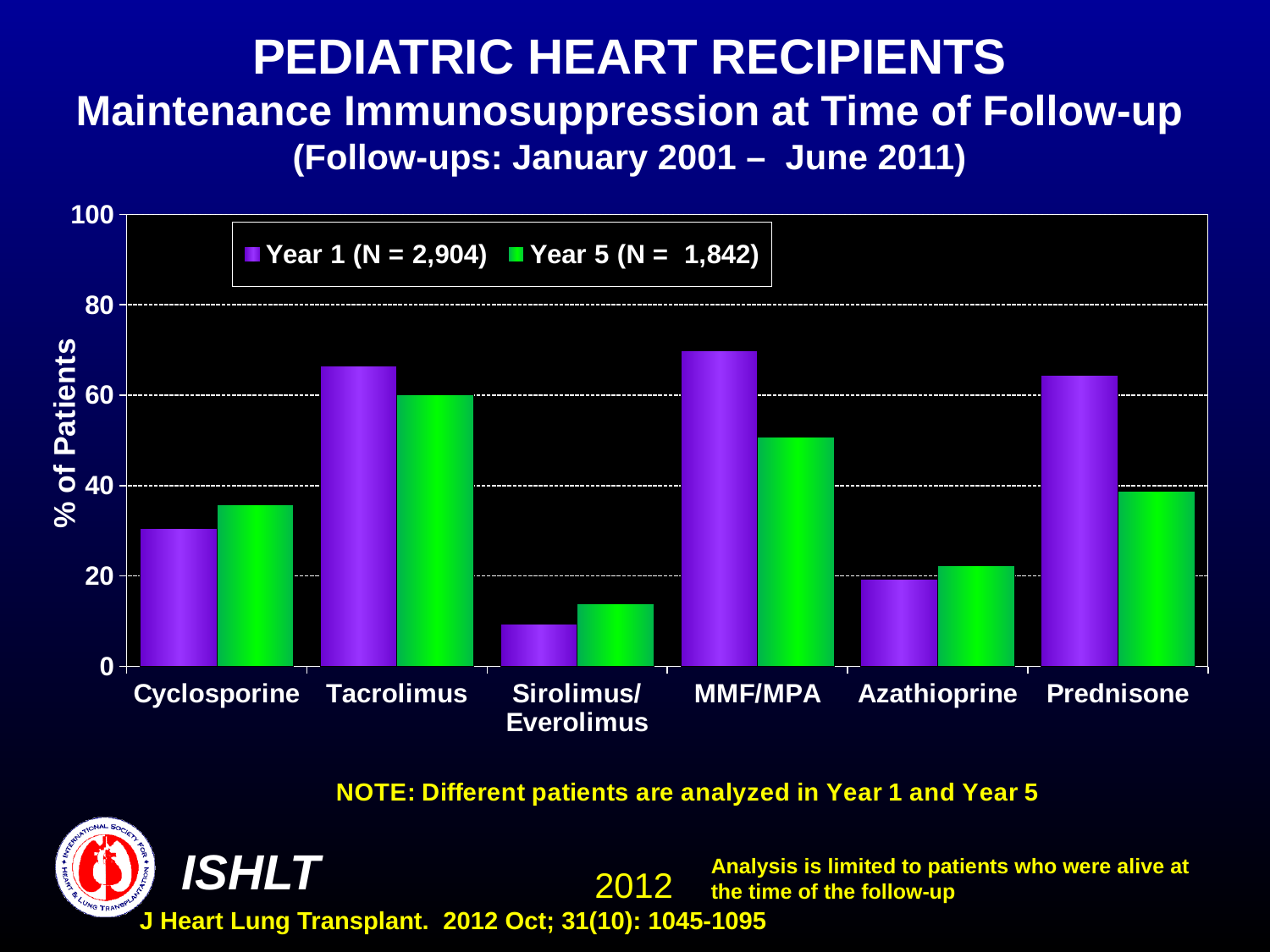
Which drug has the highest Year 5 value? Tacrolimus How many drug categories are shown on the x axis? 6 For Prednisone, which is larger: the Year 1 value or the Year 5 value? Year 1 Is the Year 1 value for MMF/MPA greater or less than 60? greater Which drug has the lowest Year 5 value? Sirolimus/Everolimus Is the Year 5 value for MMF/MPA greater or less than 40? greater What is the N given in the legend for Year 1? 2,904 Which drug has the lowest Year 1 value? Sirolimus/Everolimus How many series does the legend list? 2 What kind of chart is shown on the slide? bar chart For Cyclosporine, which is larger: the Year 1 value or the Year 5 value? Year 5 Is the Year 1 value for Sirolimus/Everolimus greater or less than 20? less